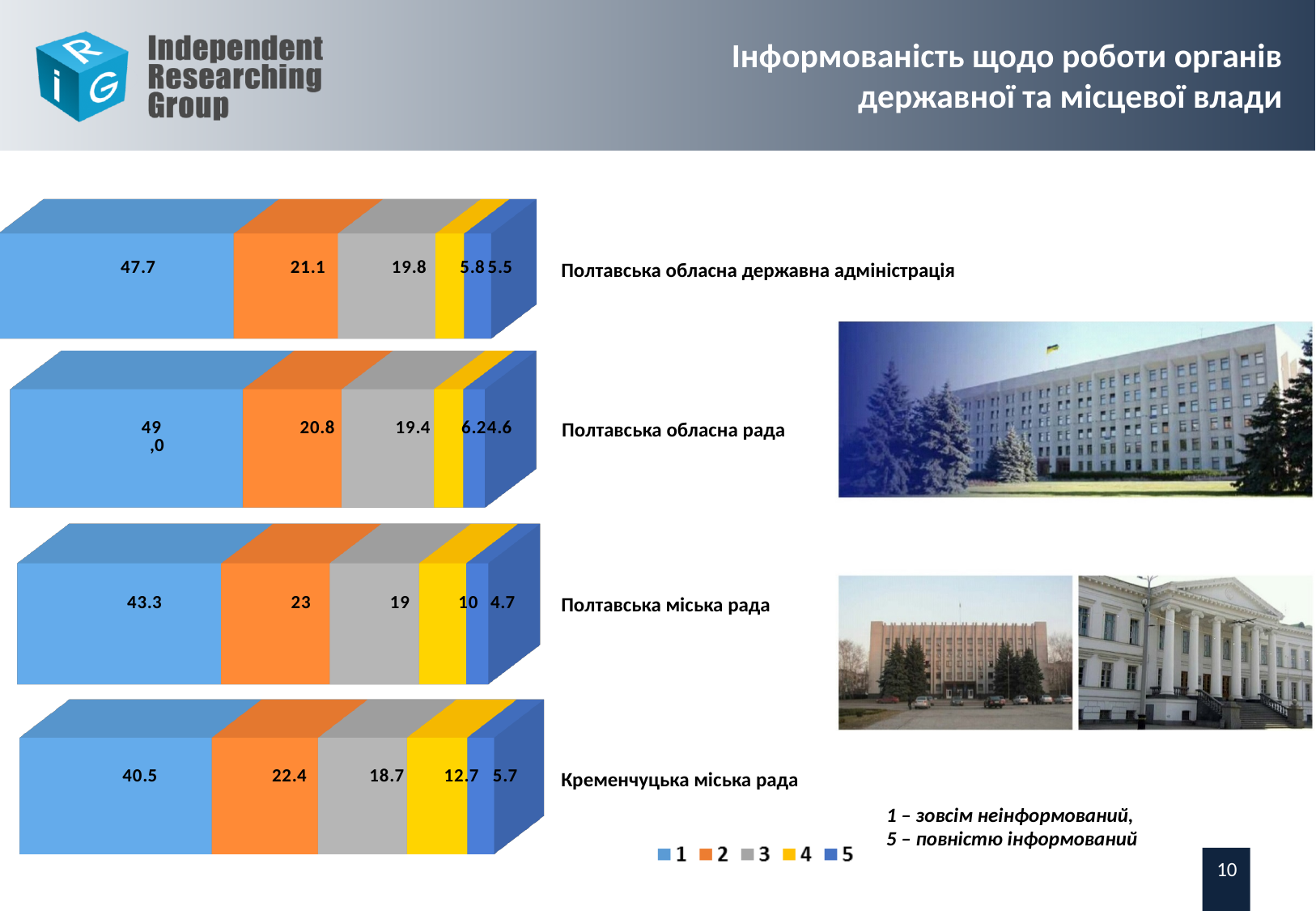
What is the value of series 1 for Полтавська обласна державна адміністрація? 47.7 What is the total of the stacked bar for Полтавська міська рада? 100 How many series does the legend list? 5 What is the value of series 2 for Полтавська міська рада? 23 What is the value of series 3 for Полтавська обласна рада? 19.4 What type of chart is shown on the slide? Stacked bar chart What is the difference between the series 1 values for Полтавська обласна державна адміністрація and Кременчуцька міська рада? 7.2 How many categories (bars) are shown in the chart? 4 Which is larger: the series 5 value for Полтавська міська рада or for Кременчуцька міська рада? Кременчуцька міська рада What is the value of series 4 for Кременчуцька міська рада? 12.7 Which category has the lowest value for series 1? Кременчуцька міська рада Which category has the highest value for series 4? Кременчуцька міська рада